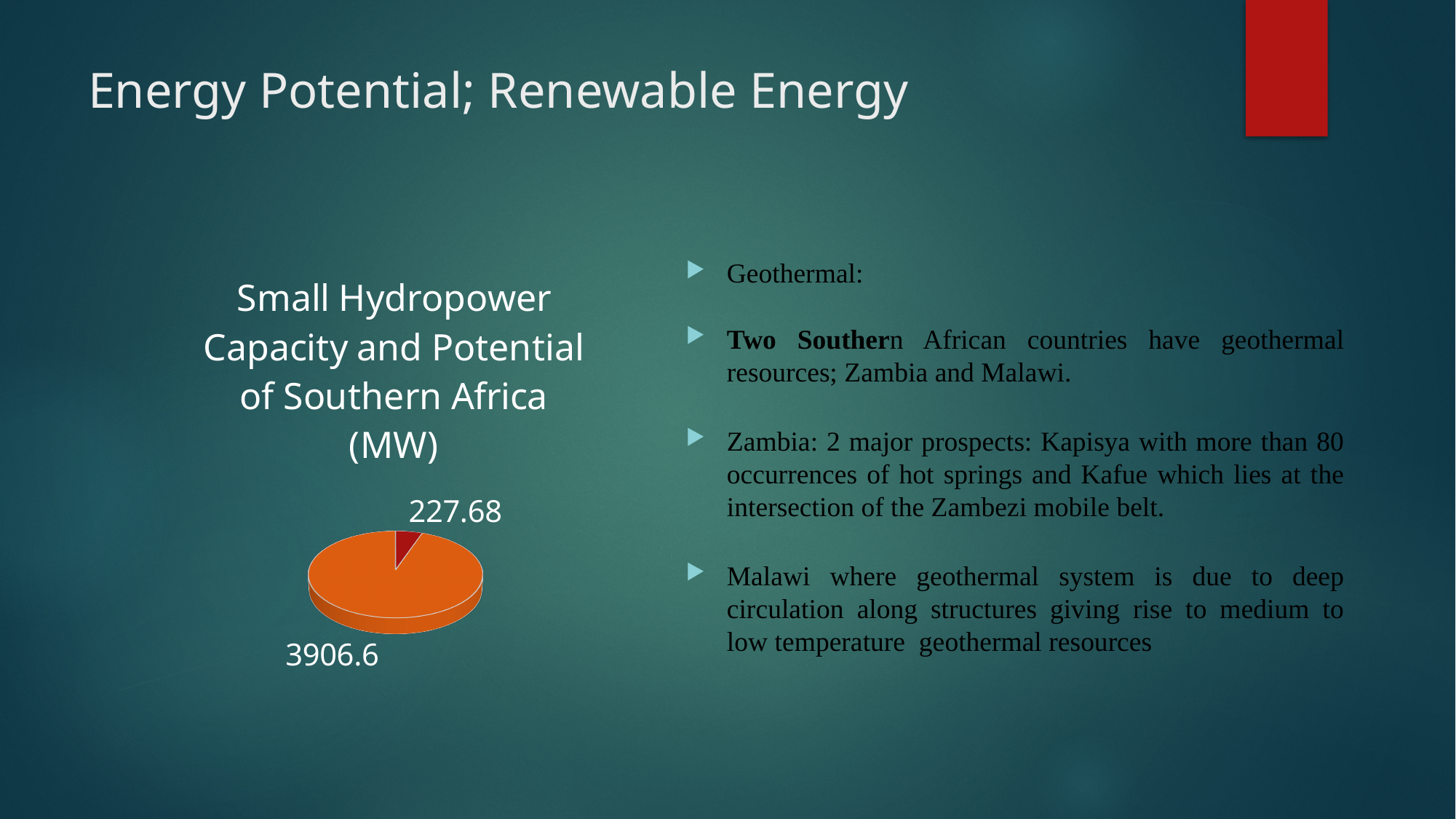
What is the difference between the two values shown in the pie chart? 3678.92 What kind of chart is shown on the slide? Pie chart To the nearest whole percent, what share of the pie does the 227.68 slice represent? 6% What is the largest value shown in the pie chart? 3906.6 What is the smallest value shown in the pie chart? 227.68 What value is labelled on the large orange slice of the pie chart? 3906.6 How many slices does the pie chart have? 2 What is the total of the two values shown in the pie chart? 4134.28 What is the title of the pie chart? Small Hydropower Capacity and Potential of Southern Africa (MW) In what unit are the values in the pie chart expressed, according to its title? MW What value is labelled on the small red slice of the pie chart? 227.68 Which slice of the pie chart is larger, the red one or the orange one? The orange one